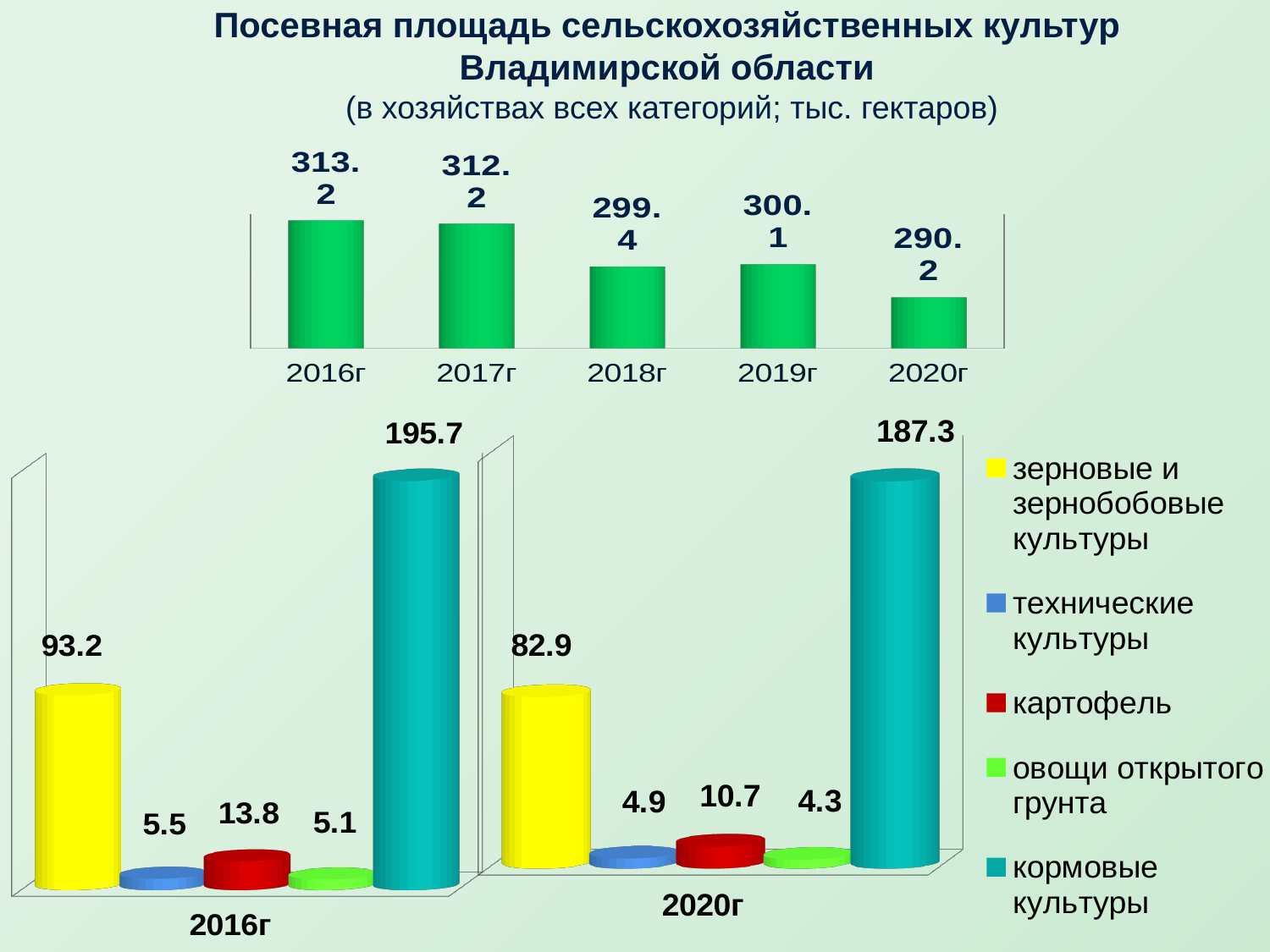
Which is larger: зерновые и зернобобовые культуры in the bottom-left chart (2016г) or in the bottom-right chart (2020г)? 2016г In the top chart, what is the difference between the values for 2016г and 2020г? 23.0 In the bottom-left chart (2016г), what is the value for кормовые культуры? 195.7 In the bottom-right chart (2020г), what is the value for картофель? 10.7 In the top chart, what is the sown area for 2016г? 313.2 In the top chart, how many years are shown? 5 How many crop categories does the legend of the bottom charts list? 5 In the top chart, which year has the lowest sown area? 2020г In the bottom-right chart (2020г), which crop category has the smallest value? овощи открытого грунта In the top chart, what is the sown area for 2020г? 290.2 In the top chart, do the values generally rise or fall from 2016г to 2020г? fall In the top chart, which year has the highest sown area? 2016г